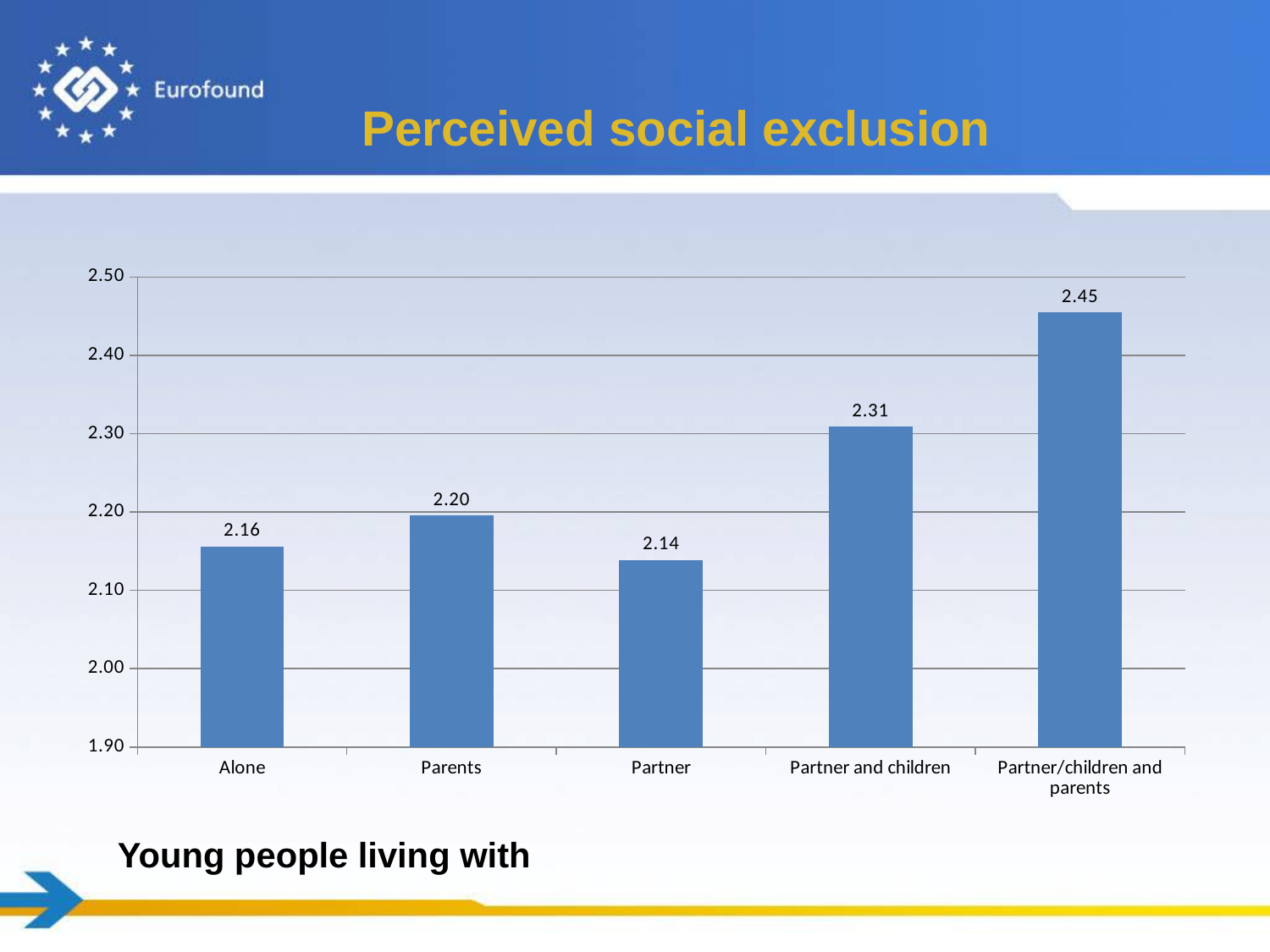
Which category has the lowest perceived social exclusion value? Partner What is the value for young people living with parents? 2.20 How many categories are shown on the x axis? 5 What is the title of the slide containing the chart? Perceived social exclusion What is the perceived social exclusion value for young people living alone? 2.16 What is the value for young people living with partner and children? 2.31 What is the value for young people living with a partner? 2.14 Which category has the highest perceived social exclusion value? Partner/children and parents What is the difference between the values for 'Partner/children and parents' and 'Partner'? 0.31 What is the difference between the values for 'Partner and children' and 'Parents'? 0.11 What kind of chart is shown on the slide? Bar chart Which is larger, the value for 'Alone' or the value for 'Parents'? Parents